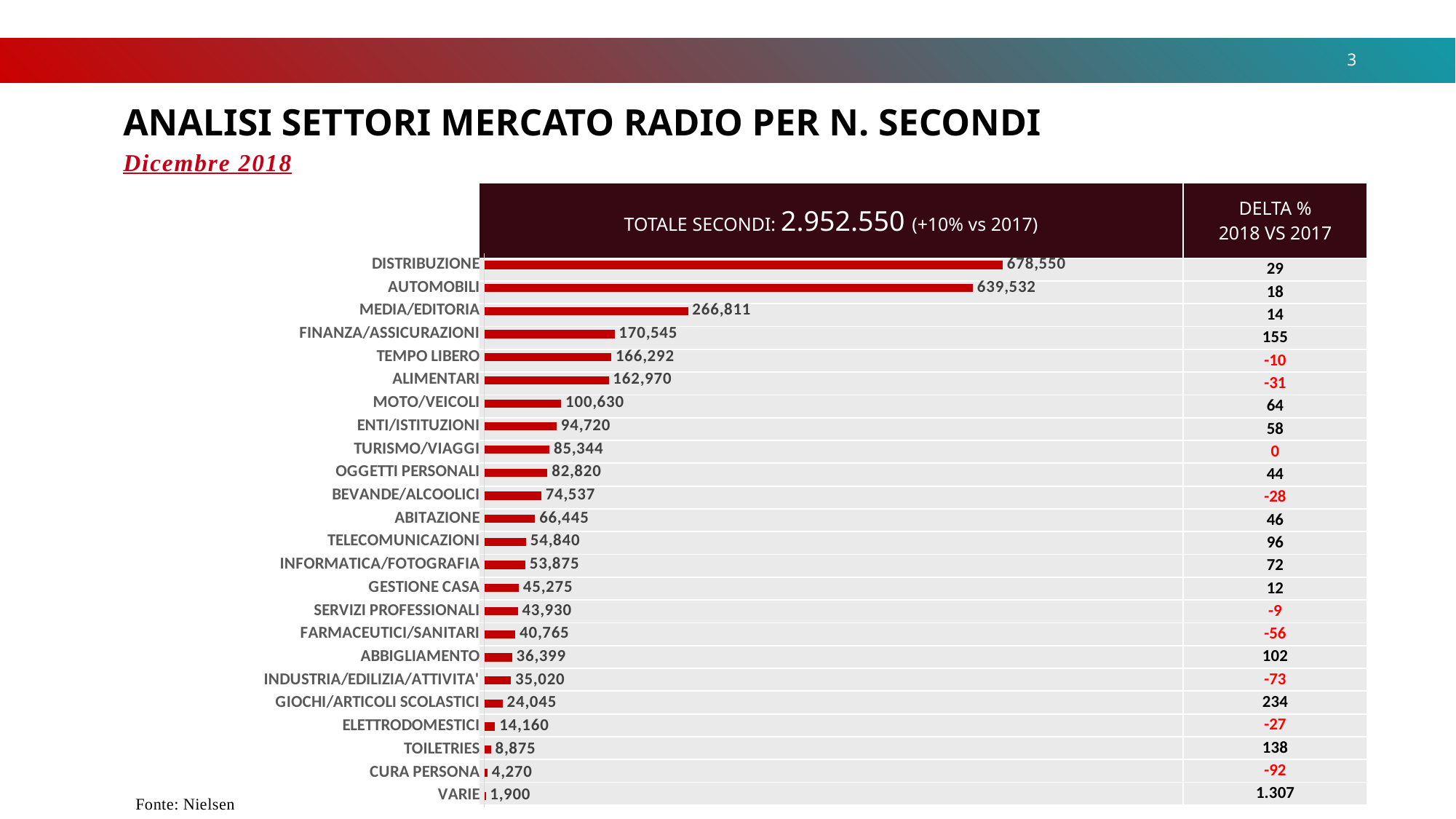
Which category has the lowest value? VARIE What is the difference between the values for MEDIA/EDITORIA and FINANZA/ASSICURAZIONI? 96,266 What is the value for ELETTRODOMESTICI? 14,160 What is the value for TELECOMUNICAZIONI? 54,840 What is the value for DISTRIBUZIONE? 678,550 What total number of seconds is stated in the chart header? 2.952.550 What is the difference between the values for DISTRIBUZIONE and AUTOMOBILI? 39,018 Which is larger, the value for MOTO/VEICOLI or the value for ENTI/ISTITUZIONI? MOTO/VEICOLI How many categories are shown in the chart? 24 Which category has the highest value? DISTRIBUZIONE What kind of chart is shown on the slide? Bar chart What is the value for MEDIA/EDITORIA? 266,811